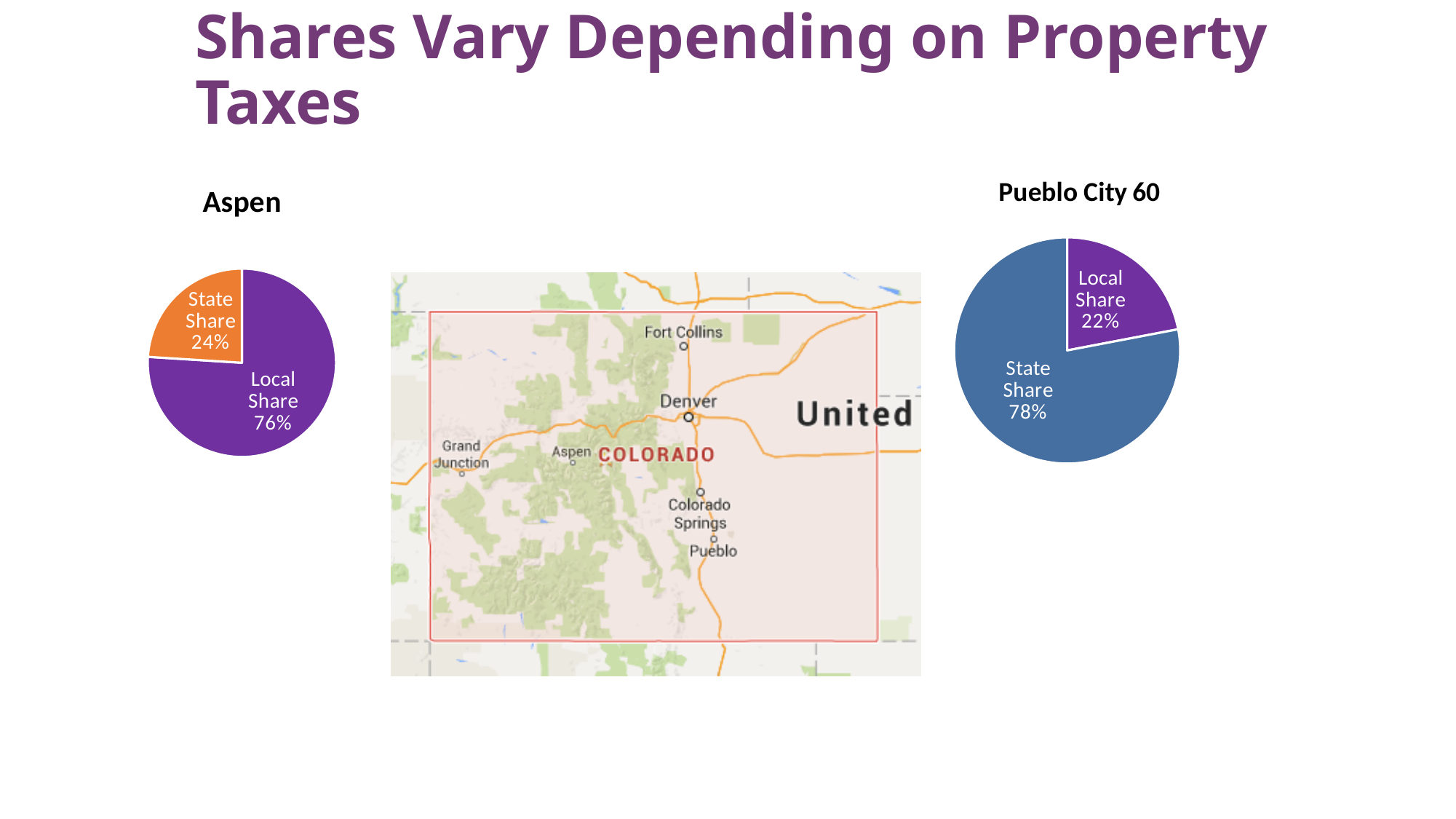
In the Aspen chart, what colour is the State Share slice? Orange In the Pueblo City 60 chart, what is the difference between the State Share and the Local Share? 56% How many slices does the Pueblo City 60 chart have? 2 In the Pueblo City 60 chart, what is the State Share? 78% Which is larger: the Local Share in the Aspen chart or the Local Share in the Pueblo City 60 chart? Aspen In the Aspen chart, what is the Local Share? 76% What kind of chart is the Aspen chart? Pie chart In the Aspen chart, what is the State Share? 24% In the Aspen chart, which slice is the largest? Local Share In the Pueblo City 60 chart, what is the Local Share? 22% In the Aspen chart, what is the difference between the Local Share and the State Share? 52% In the Pueblo City 60 chart, which slice is the smallest? Local Share